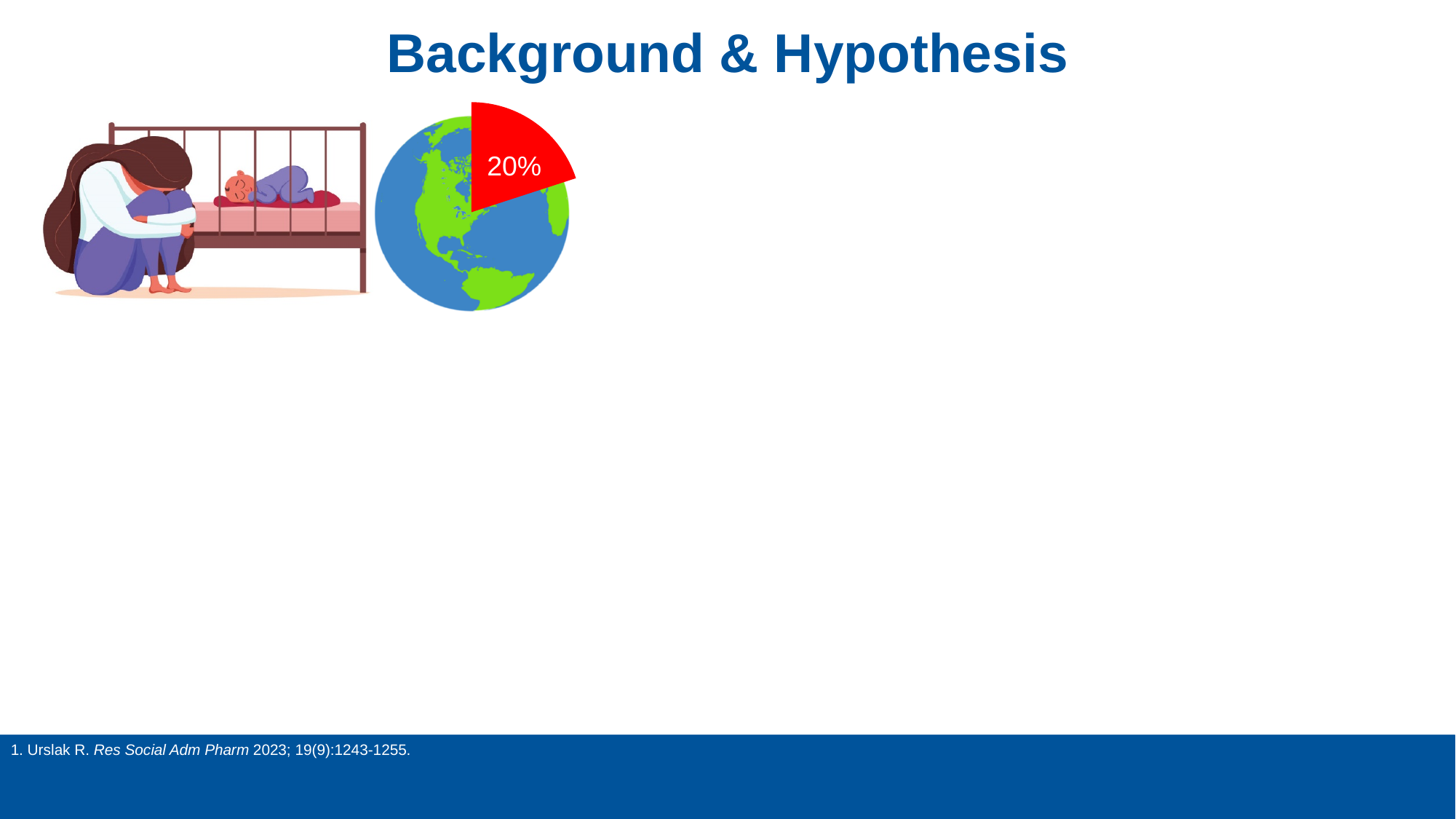
What percentage is printed on the red slice overlaid on the globe? 20% What colour is the slice labelled 20%? red Is the value shown on the red slice greater or less than 50%? less How many labelled slices does the pie on the globe show? 1 What kind of chart is the red segment on the globe? pie chart